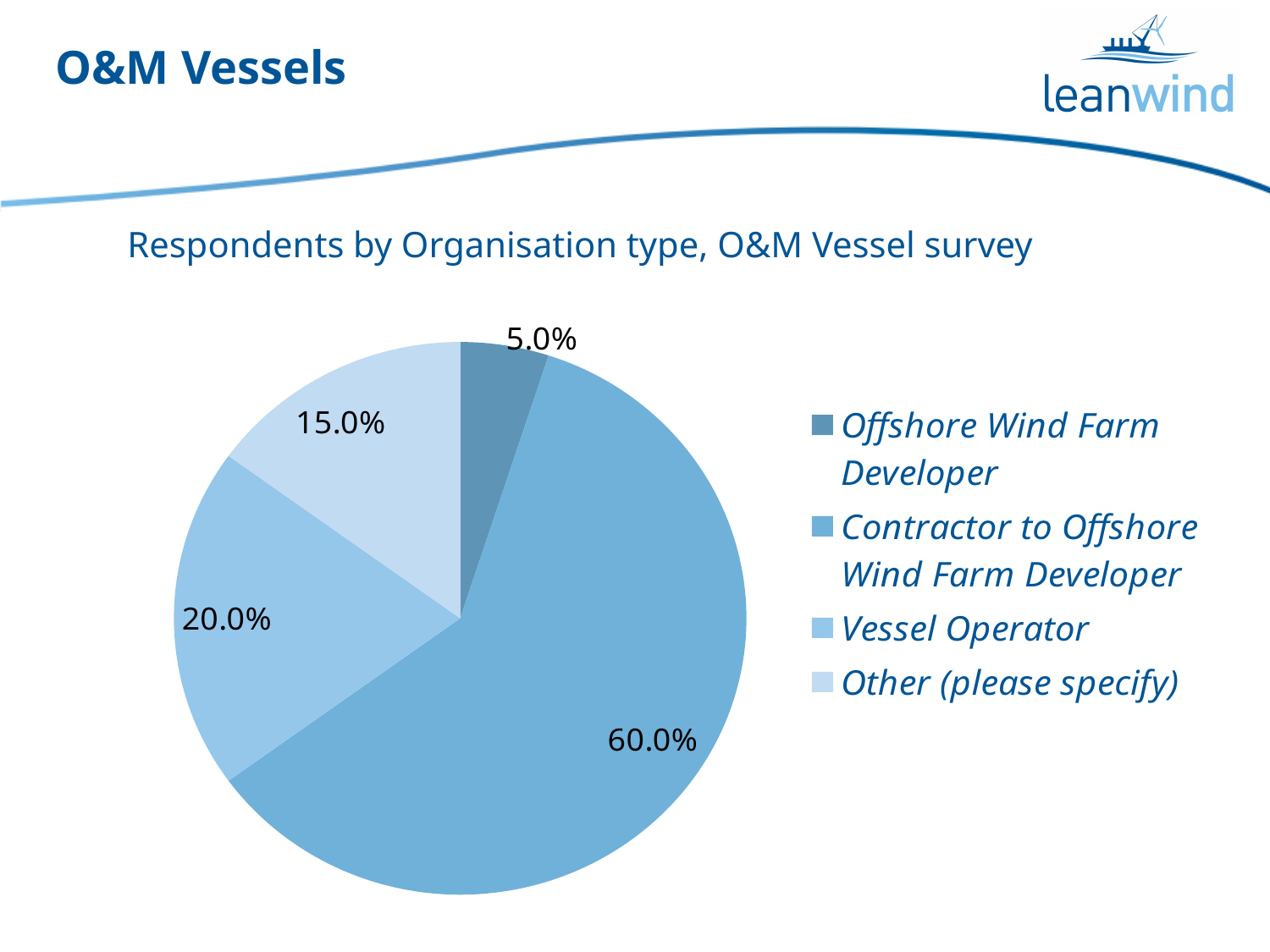
How many organisation types are shown in the pie chart? 4 What kind of chart is shown on the slide? Pie chart What share of respondents are Contractors to Offshore Wind Farm Developers? 60.0% Which is larger: the share for Vessel Operator or the share for Other (please specify)? Vessel Operator What share of respondents are Offshore Wind Farm Developers? 5.0% What share of respondents are Vessel Operators? 20.0% What share of respondents fall under Other (please specify)? 15.0% What is the difference in percentage points between the Contractor to Offshore Wind Farm Developer share and the Vessel Operator share? 40.0% Which organisation type has the smallest share of respondents? Offshore Wind Farm Developer Which organisation type has the largest share of respondents? Contractor to Offshore Wind Farm Developer What is the title of the chart? Respondents by Organisation type, O&M Vessel survey What is the difference in percentage points between the Vessel Operator share and the Other (please specify) share? 5.0%